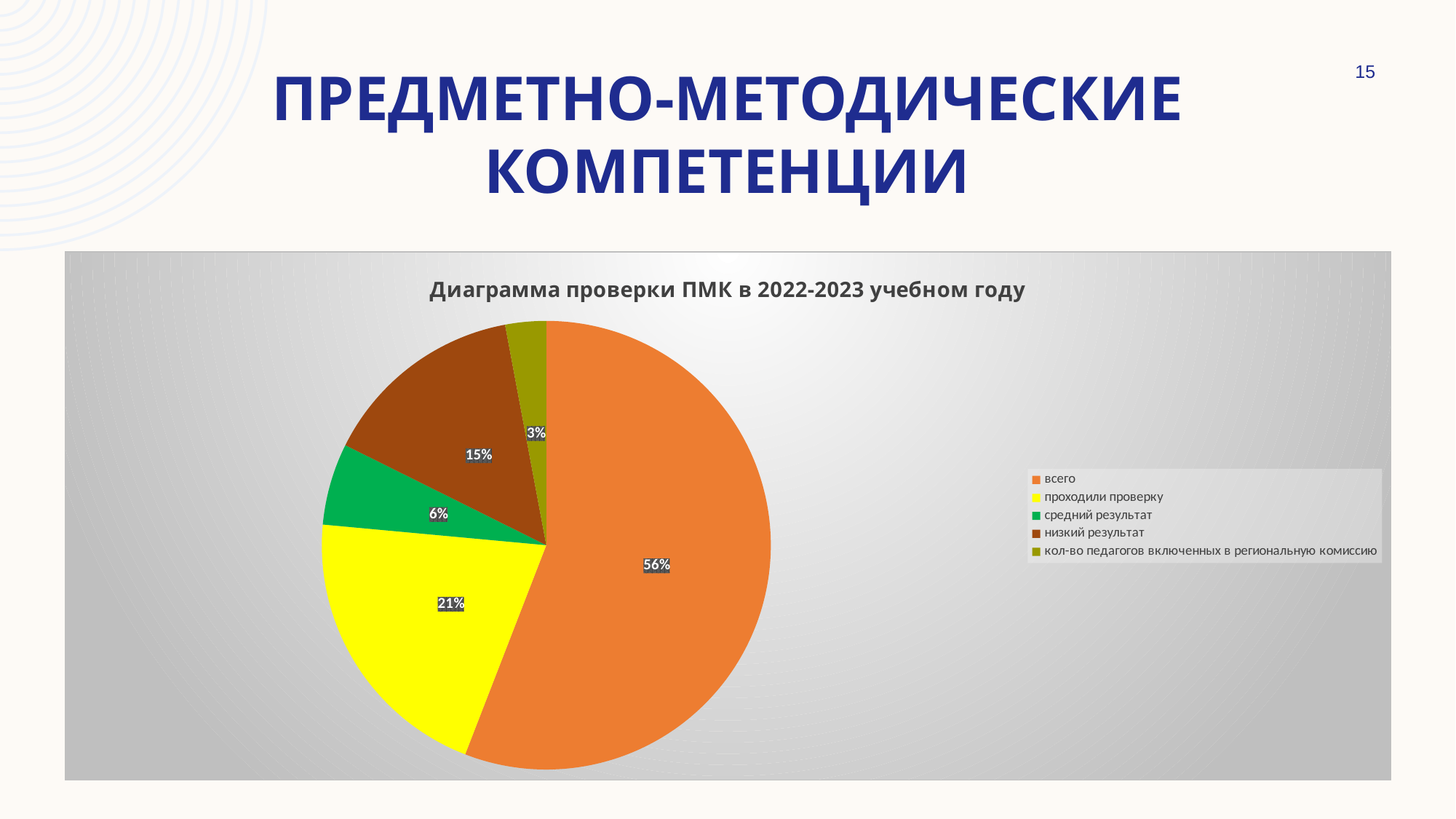
What share of the pie does the slice 'проходили проверку' take? 21% Which slice of the pie is the smallest? кол-во педагогов включенных в региональную комиссию What share of the pie does the slice 'низкий результат' take? 15% Which slice of the pie is the largest? всего How many slices does the pie chart have? 5 What is the title of the chart? Диаграмма проверки ПМК в 2022-2023 учебном году Which slice is larger, 'средний результат' or 'низкий результат'? низкий результат What share of the pie does the slice 'средний результат' take? 6% What kind of chart is shown on the slide? pie chart What is the difference between the shares of 'проходили проверку' and 'низкий результат'? 6%